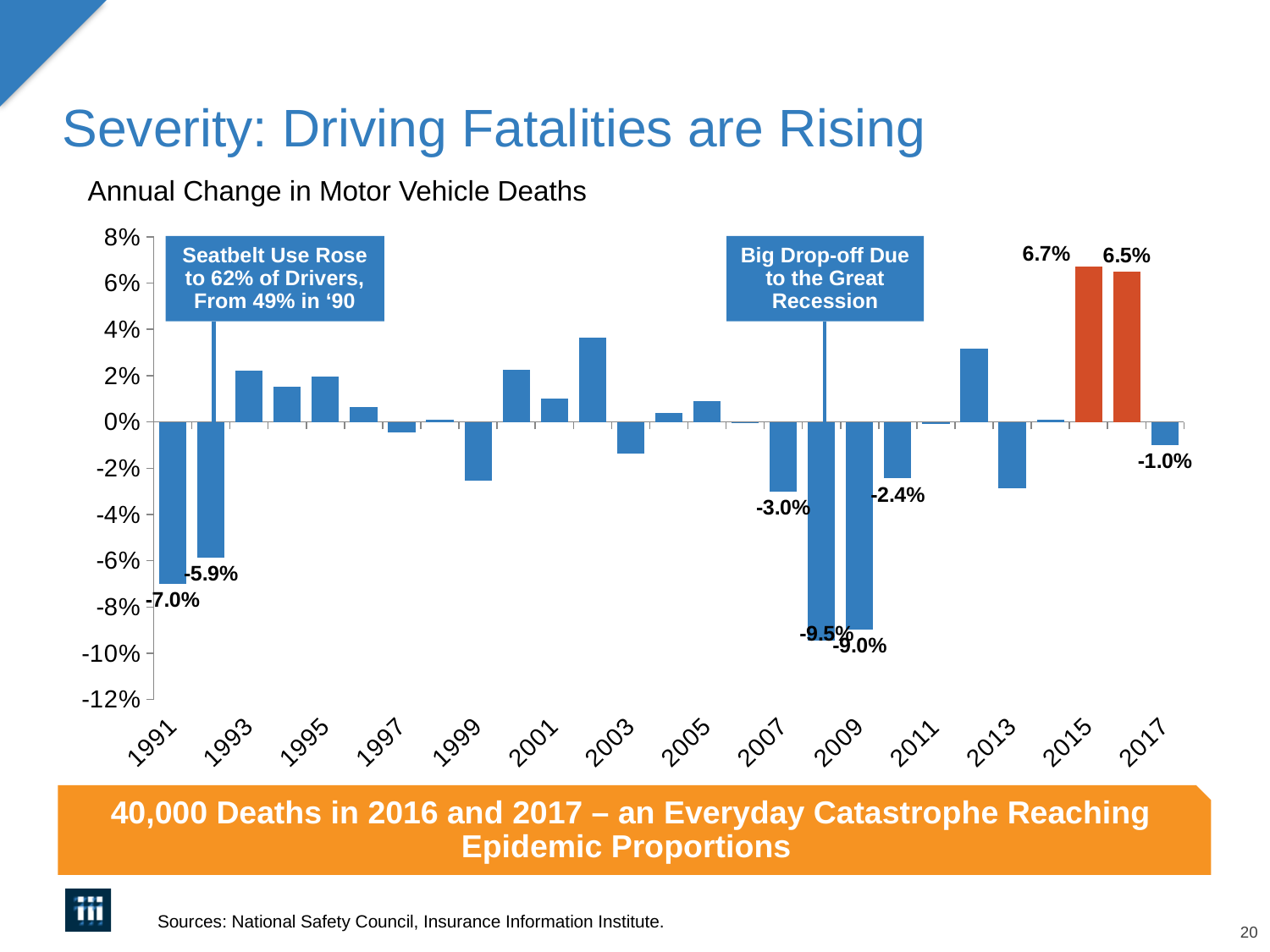
What is the title of the chart? Annual Change in Motor Vehicle Deaths Which year has the highest annual change in motor vehicle deaths? 2015 What value is labeled for 1991? -7.0% What value is labeled for 2008? -9.5% Is the value for 2002 greater or less than 2%? greater By how many percentage points does the 2015 value exceed the 2016 value? 0.2 percentage points What kind of chart is shown on the slide? Bar chart What value is labeled for 2017? -1.0% Which year has the lowest annual change in motor vehicle deaths? 2008 Which year shows the larger decline, 2008 or 2009? 2008 What is the annual change in motor vehicle deaths shown for 2016? 6.5% What is the annual change in motor vehicle deaths shown for 2015? 6.7%